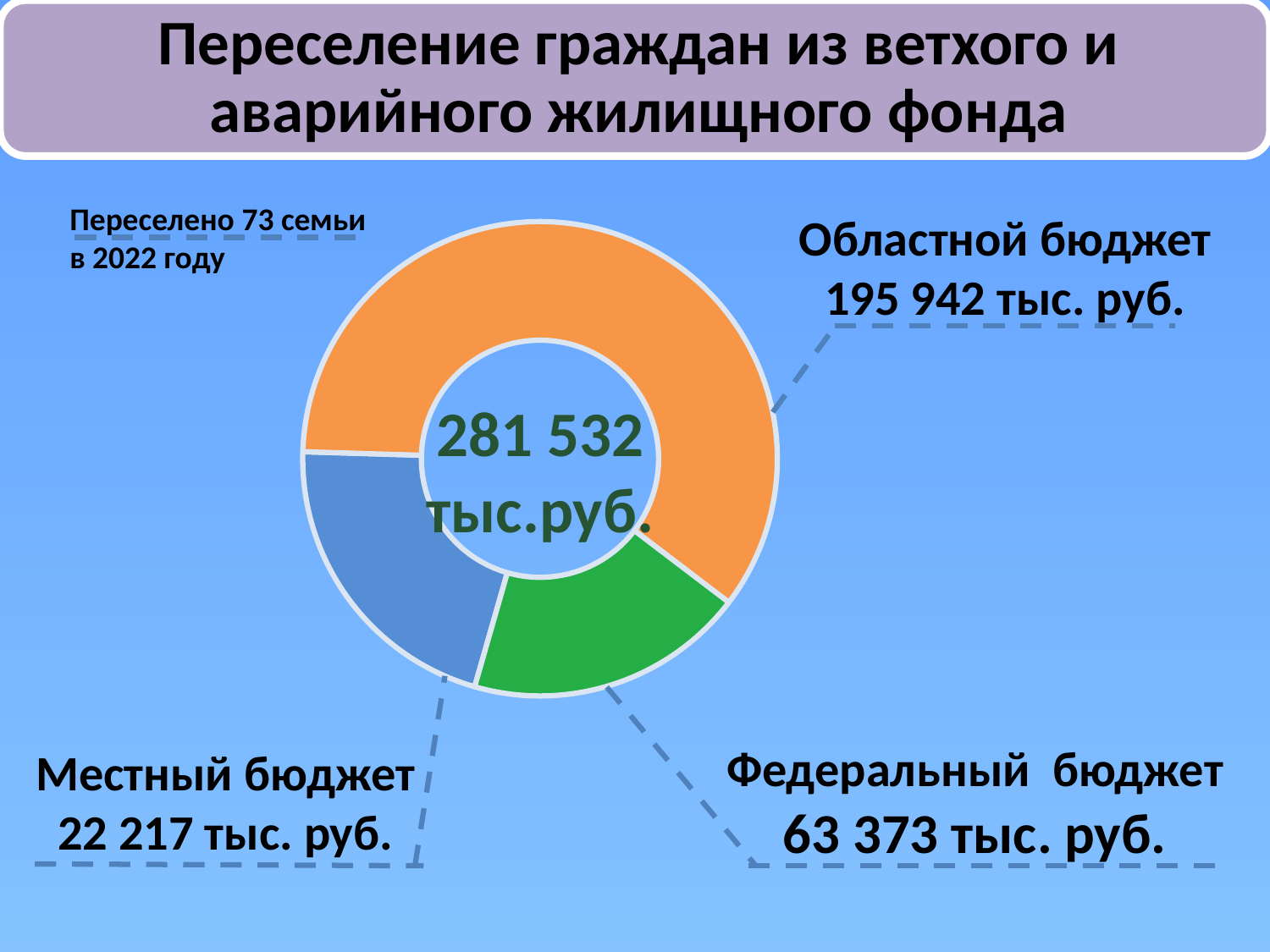
What kind of chart is shown on the slide? Donut (pie) chart What colour is the segment for Федеральный бюджет? Green What is the value for Федеральный бюджет? 63 373 тыс. руб. What is the difference between Федеральный бюджет and Местный бюджет? 41 156 тыс. руб. What is the value for Местный бюджет? 22 217 тыс. руб. What is the difference between Областной бюджет and Федеральный бюджет? 132 569 тыс. руб. What is the total value shown in the centre of the chart? 281 532 тыс.руб. Which is larger, Федеральный бюджет or Местный бюджет? Федеральный бюджет What is the value for Областной бюджет? 195 942 тыс. руб. Which budget source has the largest value? Областной бюджет How many segments does the chart have? 3 Which budget source has the smallest value? Местный бюджет